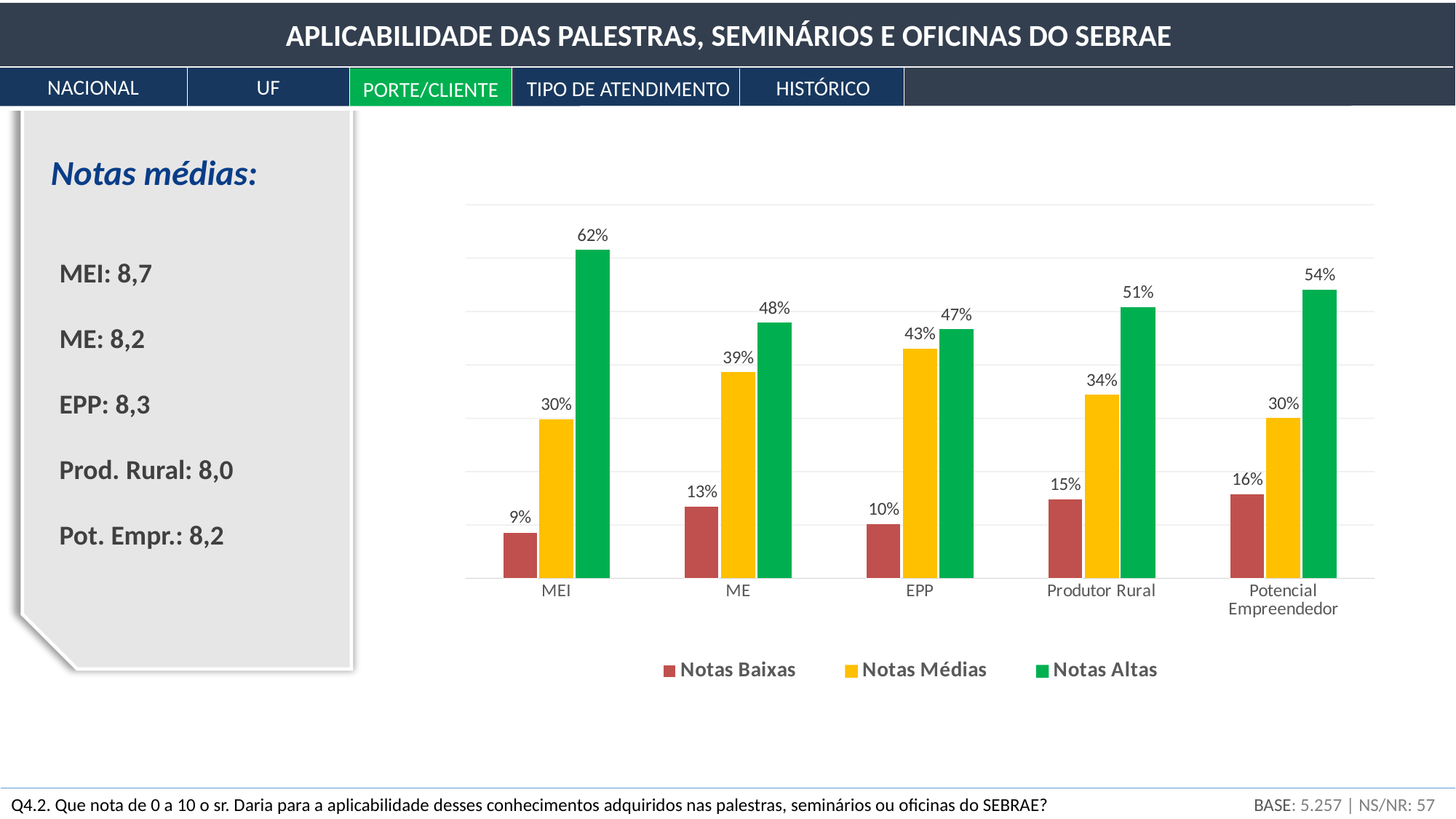
How many series does the legend list? 3 What is the difference between Notas Altas and Notas Médias for ME? 9% How many categories are shown on the x axis? 5 Which is larger: Notas Altas for Produtor Rural or Notas Altas for Potencial Empreendedor? Potencial Empreendedor Which colour represents Notas Altas in the legend? Green What is the value of Notas Altas for MEI? 62% What is the value of Notas Baixas for Produtor Rural? 15% Which category has the lowest Notas Baixas value? MEI What is the value of Notas Médias for EPP? 43% What kind of chart is shown? Bar chart Which category has the highest Notas Altas value? MEI What is the total of Notas Baixas, Notas Médias and Notas Altas for EPP? 100%